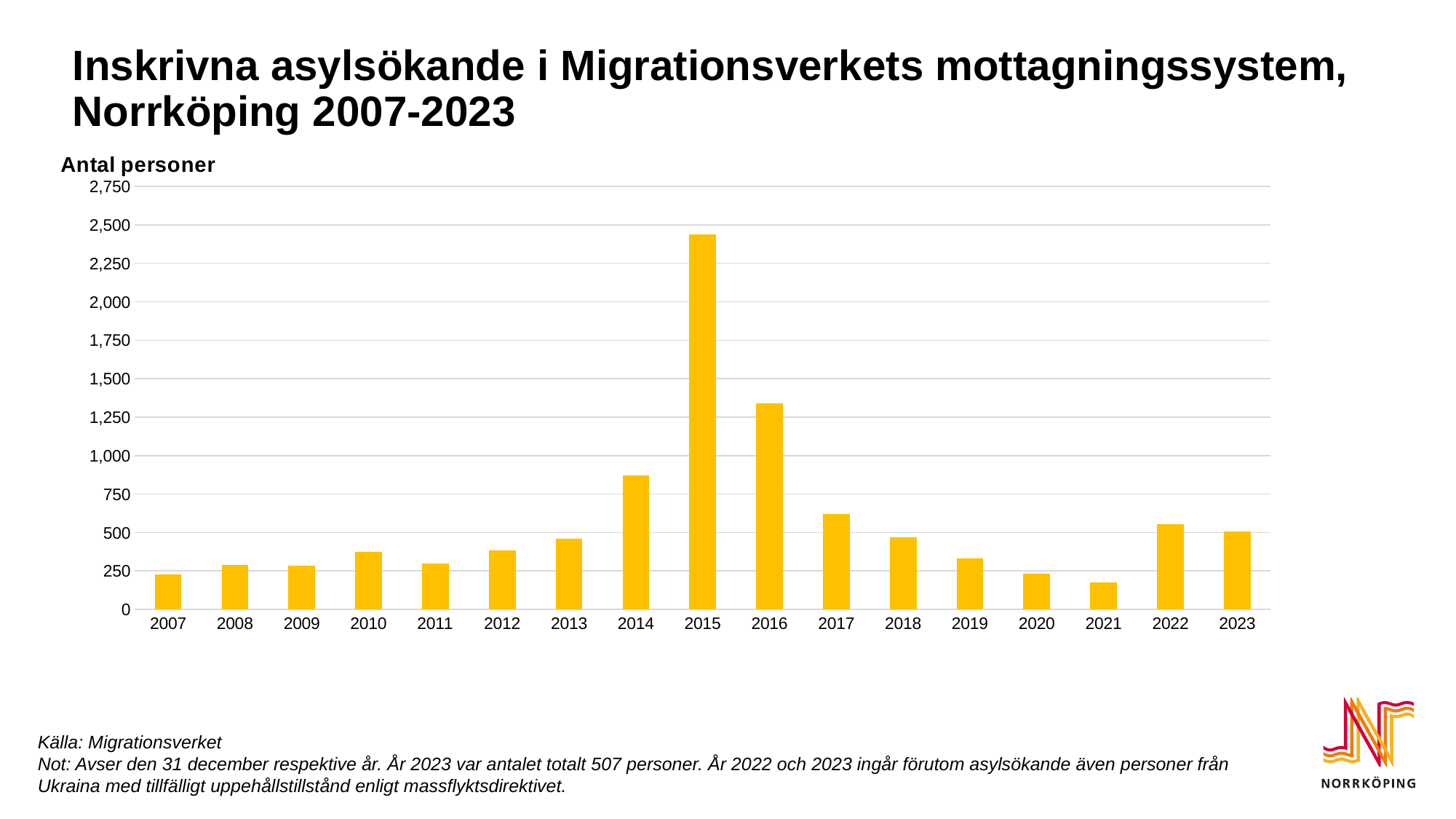
According to the note on the slide, how many persons were registered in 2023? 507 Which year has the lowest number of registered asylum seekers? 2021 Is the value for 2014 greater or less than 750? greater Which year has a higher value, 2014 or 2016? 2016 Do the values rise or fall from 2015 to 2021? fall What is the label of the y axis? Antal personer Is the value for 2017 greater or less than 750? less Is the value for 2015 greater or less than 2,250? greater What type of chart is shown on the slide? Bar chart How many years are shown on the x axis? 17 Which year has the highest number of registered asylum seekers? 2015